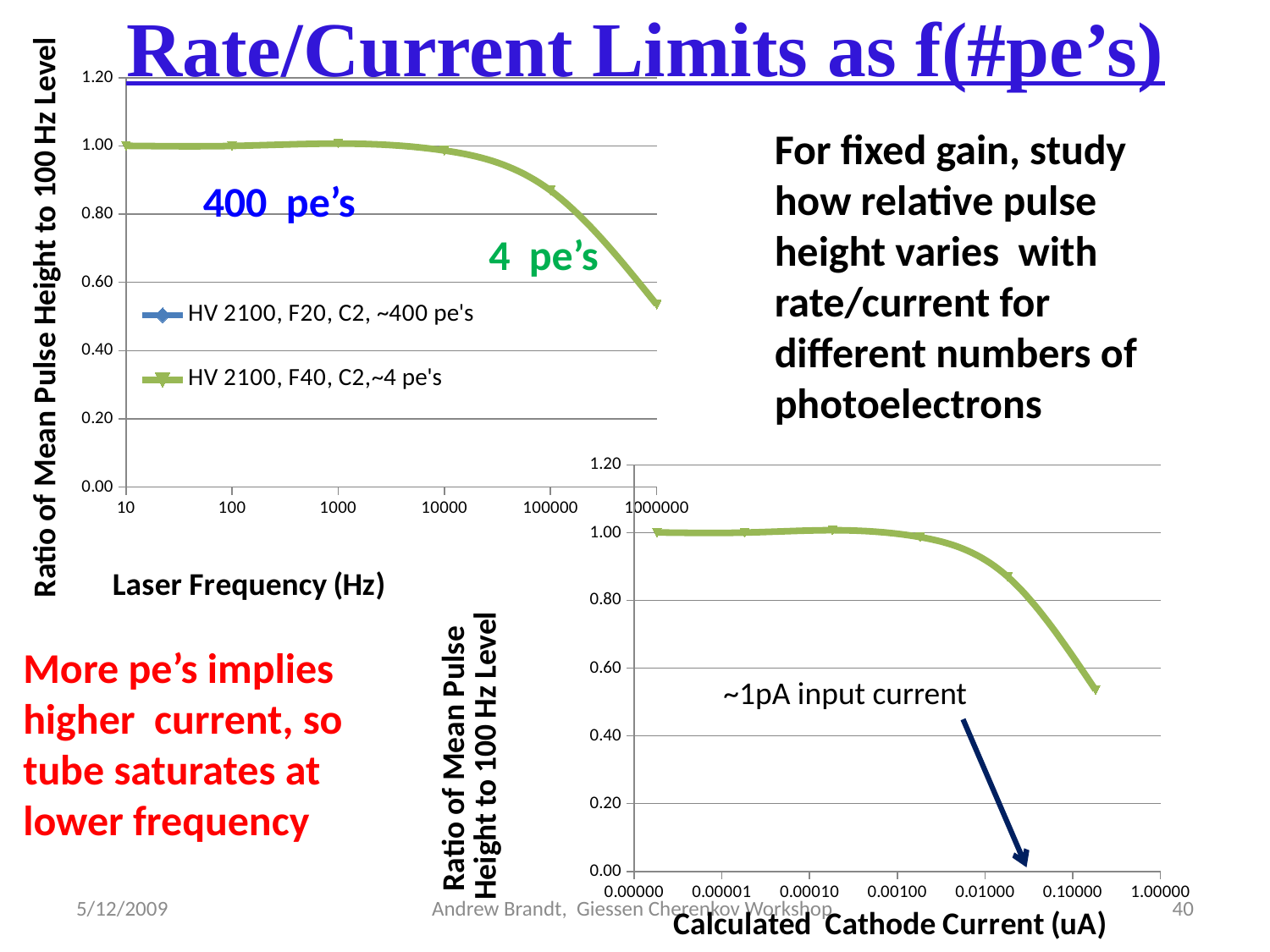
In the bottom-right chart (Calculated Cathode Current), is the value at 0.10000 uA greater or less than 0.80? less In the top-left chart (Laser Frequency), is the value at 1000000 Hz greater or less than 0.80? less How many series does the legend of the top-left chart (Laser Frequency) list? 2 In the top-left chart (Laser Frequency), do the plotted values rise or fall as the laser frequency increases toward 1000000 Hz? fall In the top-left chart (Laser Frequency), is the value at 100 Hz greater or less than 0.80? greater What kind of chart is the top-left chart with the x axis labelled Laser Frequency (Hz)? line chart What kind of chart is the bottom-right chart with the x axis labelled Calculated Cathode Current (uA)? line chart In the top-left chart (Laser Frequency), what is the first series named in the legend? HV 2100, F20, C2, ~400 pe's What is the x-axis title of the bottom-right chart? Calculated Cathode Current (uA) How many data points are plotted on the line in the top-left chart (Laser Frequency)? 6